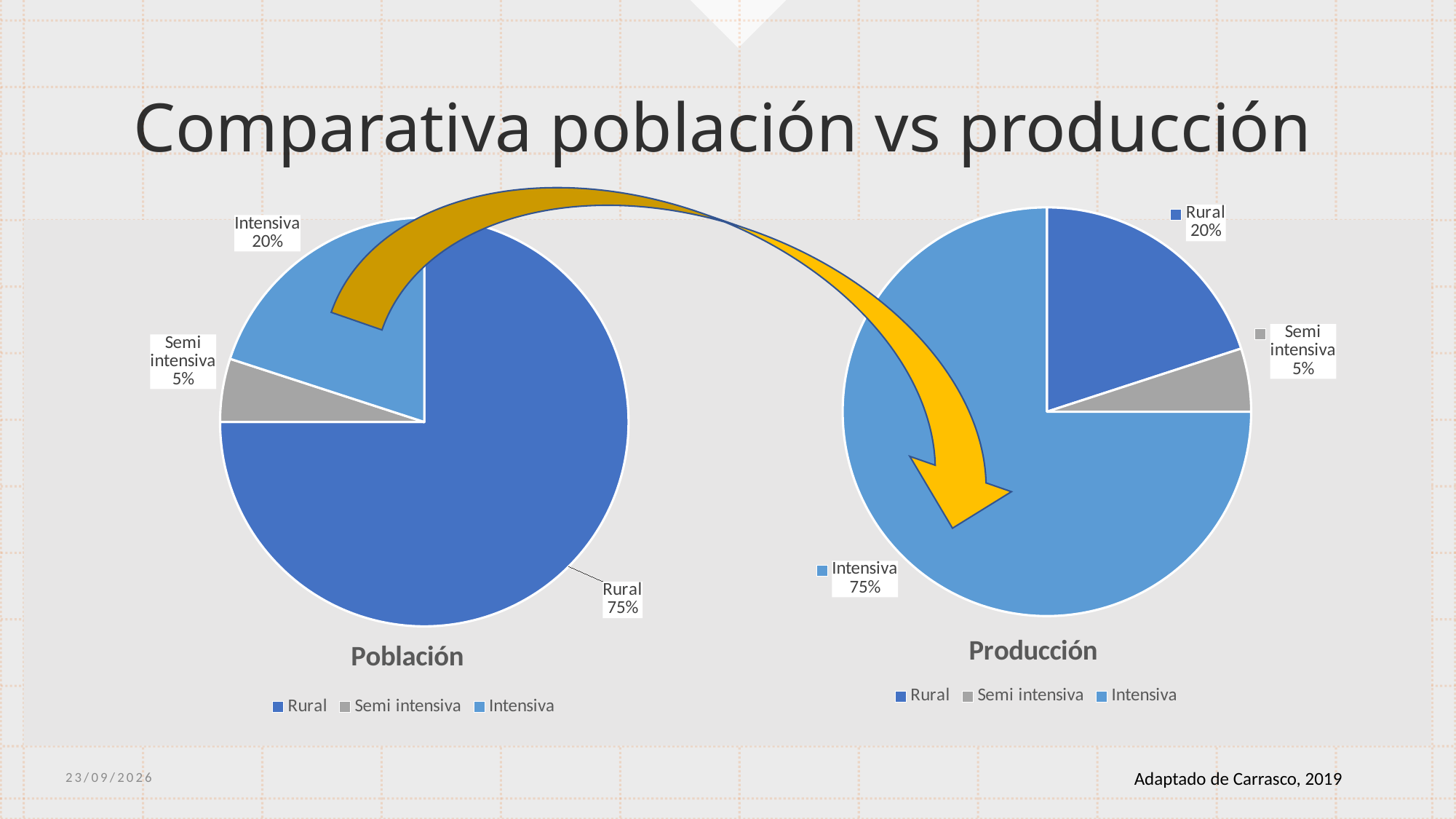
In the Producción pie chart, what share does Semi intensiva have? 5% How many categories does the Población pie chart show? 3 In the Producción pie chart, what share does Rural have? 20% In the Producción pie chart, which category has the smallest slice? Semi intensiva What kind of chart is the Producción chart? Pie chart In the Producción pie chart, what share does Intensiva have? 75% What is the title of the slide containing the two charts? Comparativa población vs producción In the Población pie chart, what share does Rural have? 75% In the Población pie chart, which category has the largest slice? Rural In the Población pie chart, what is the difference between the Rural and Intensiva shares? 55% In the Producción pie chart, which is larger, Rural or Semi intensiva? Rural In the Población pie chart, what share does Intensiva have? 20%